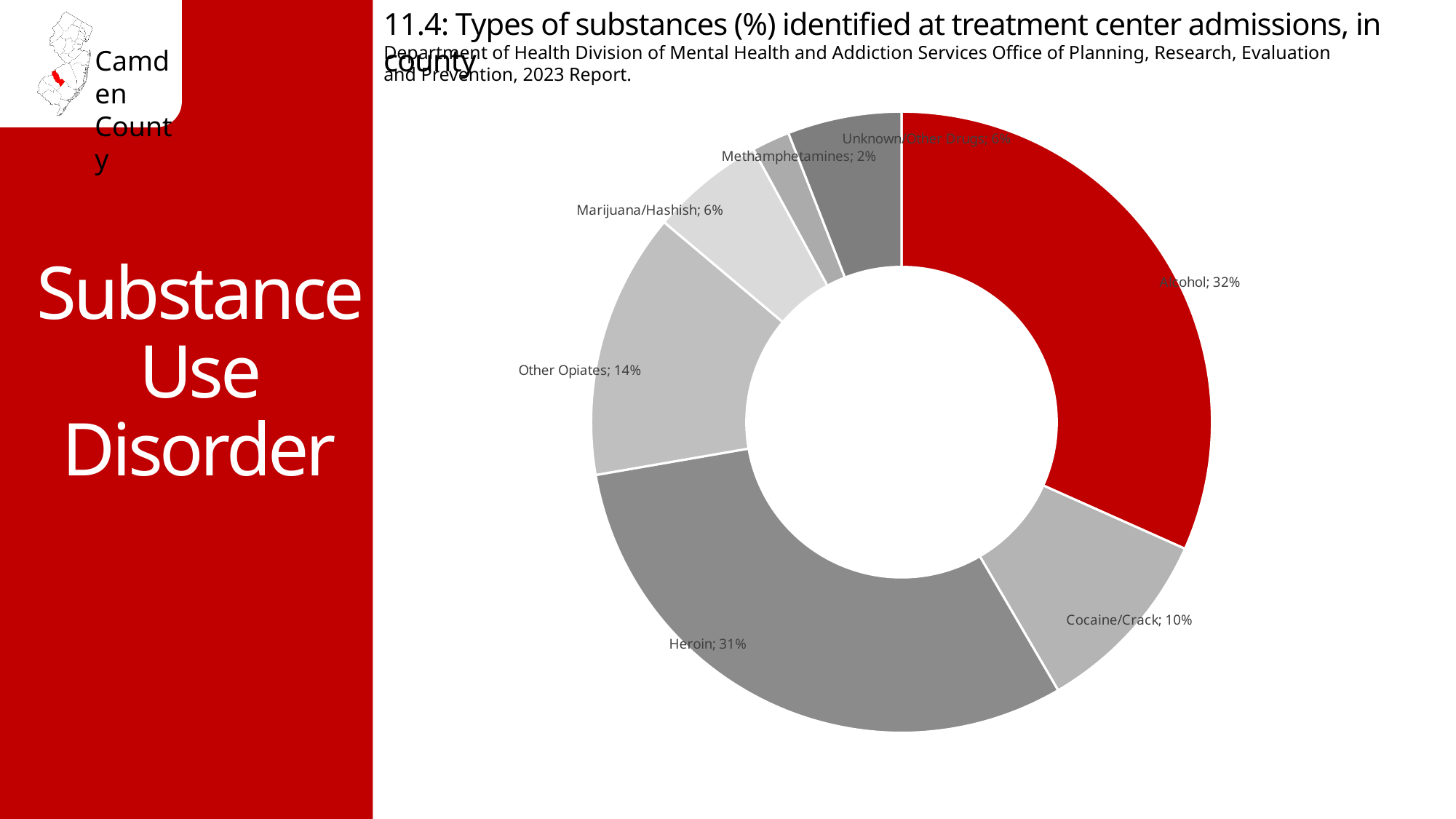
Which substance has the smallest share of admissions? Methamphetamines What is the difference in percentage points between Other Opiates and Marijuana/Hashish? 8 What colour is the Alcohol slice of the chart? red What percentage is shown for Cocaine/Crack? 10% Which substance has the largest share of admissions? Alcohol What percentage is shown for Other Opiates? 14% How many substance categories are shown in the chart? 7 Which has a larger share, Heroin or Other Opiates? Heroin What is the difference in percentage points between Alcohol and Cocaine/Crack? 22 What percentage of treatment center admissions is attributed to Alcohol? 32% What percentage is shown for Heroin? 31% What kind of chart is shown on the slide? doughnut chart